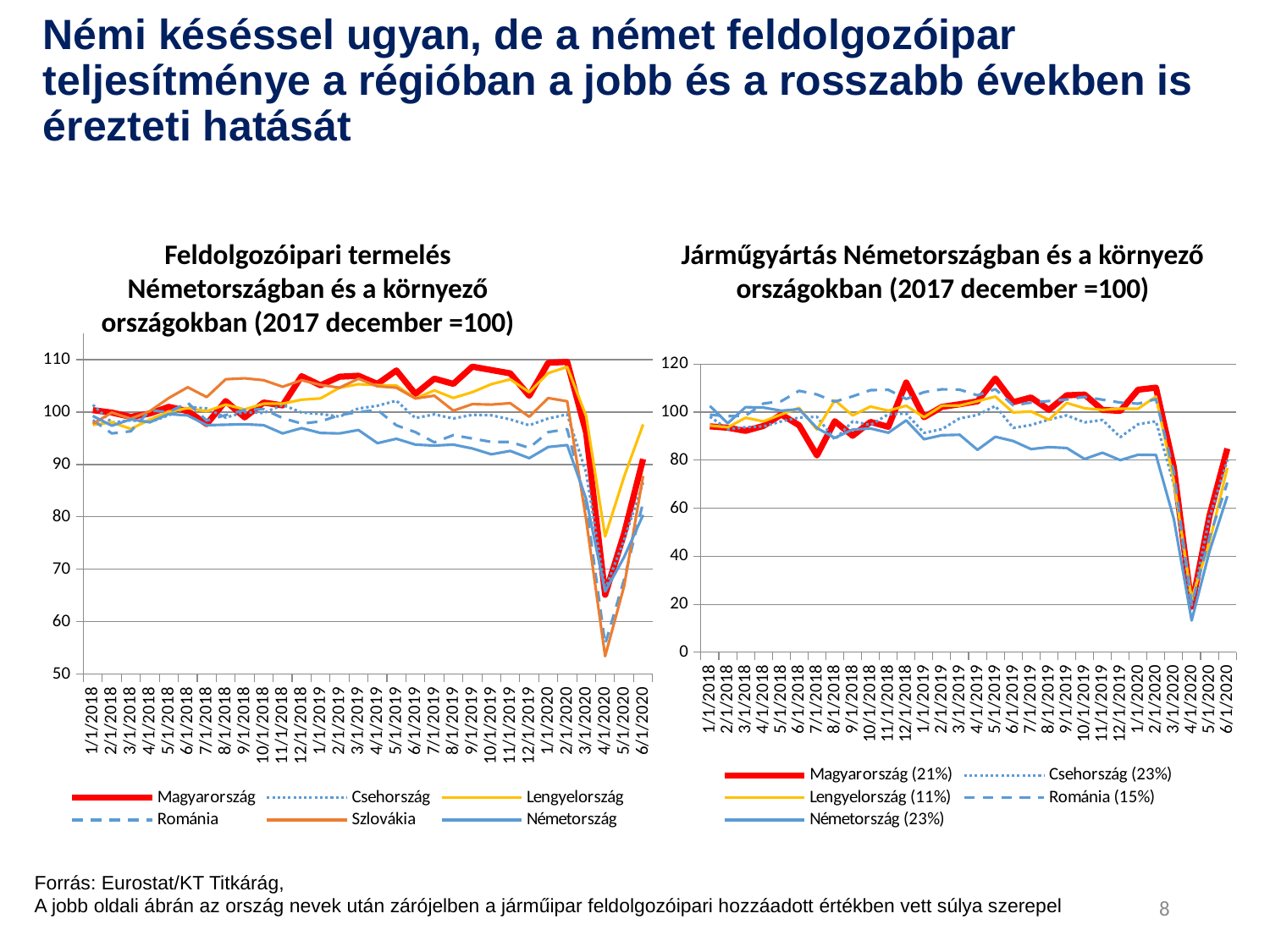
How many series does the legend of the right chart, 'Járműgyártás Németországban és a környező országokban', list? 5 In the right chart's legend, what percentage is shown in parentheses after Lengyelország? 11% In the right chart, is the value for Németország (23%) at 12/1/2019 greater or less than 100? less In the left chart, is the value for Szlovákia at 4/1/2020 greater or less than 60? less How many series does the legend of the left chart list? 6 In the left chart, is the value for Lengyelország at 4/1/2020 greater or less than 70? greater How many monthly points are shown on the x axis of the right chart? 30 In the right chart, does the Németország (23%) line rise or fall overall from 1/1/2018 to 6/1/2020? fall In the right chart, which series has the lowest value at 4/1/2020? Németország (23%) In the left chart, which series has the lowest value at 4/1/2020? Szlovákia What kind of chart is the left chart, 'Feldolgozóipari termelés Németországban és a környező országokban'? line chart What is the base period given in the title of the left chart? 2017 december =100